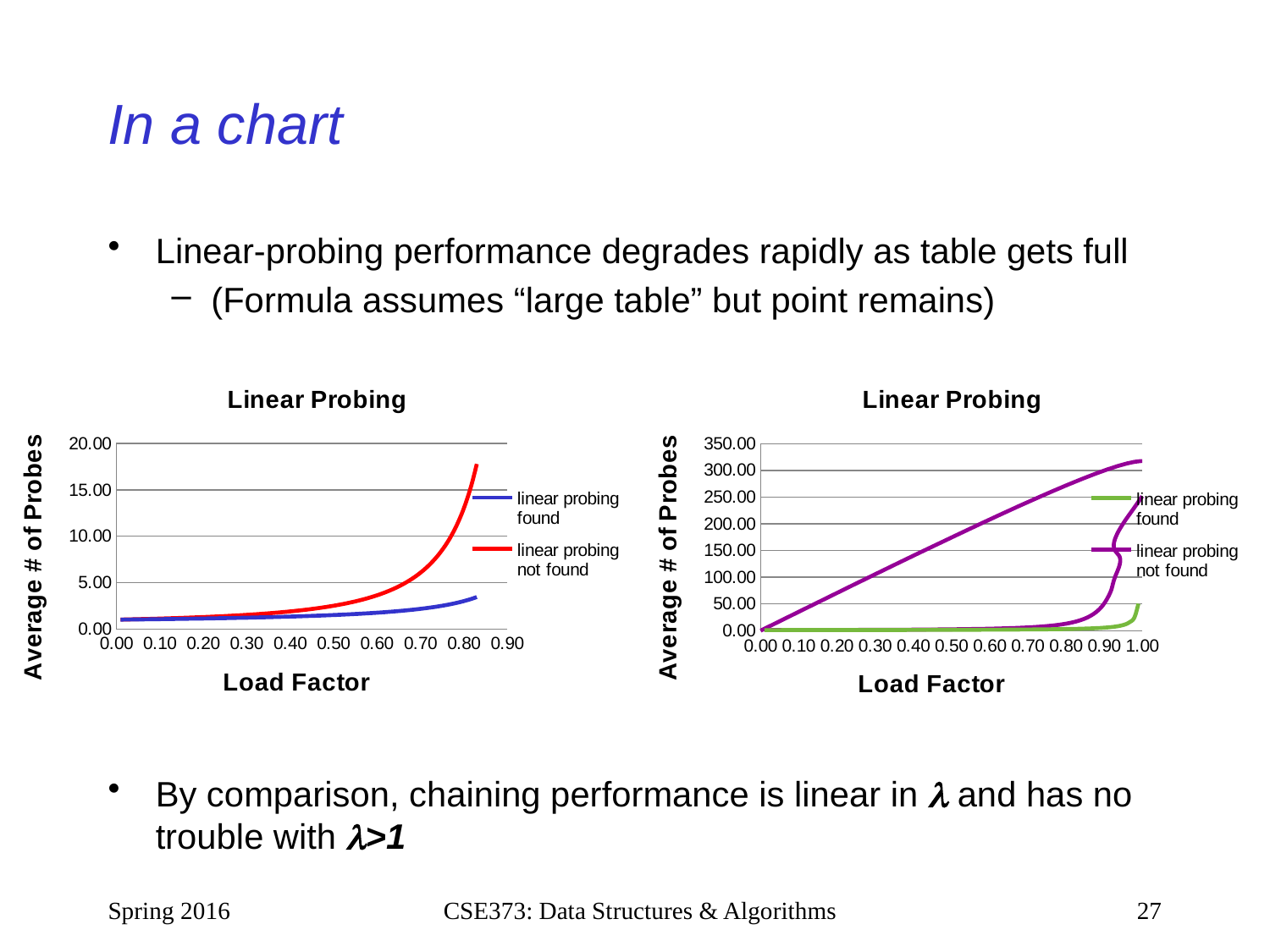
In the chart on the left, at load factor 0.80, which series has the larger value: 'linear probing found' or 'linear probing not found'? linear probing not found In the chart on the left, is the value of 'linear probing not found' at load factor 0.80 greater or less than 5.00? greater In the chart on the left, does the 'linear probing not found' line rise or fall as the load factor increases? rise How many series does the legend of the chart on the right list? 2 In the chart on the left, what is the label of the y axis? Average # of Probes In the chart on the left, is the value of 'linear probing found' at load factor 0.80 greater or less than 5.00? less What kind of chart is the chart on the left? line chart What kind of chart is the chart on the right? line chart In the chart on the right, does the 'linear probing found' line rise or fall as the load factor increases? rise In the chart on the right, is the value of 'linear probing found' at load factor 0.90 greater or less than 50.00? less What is the title of the chart on the left? Linear Probing How many series does the legend of the chart on the left list? 2